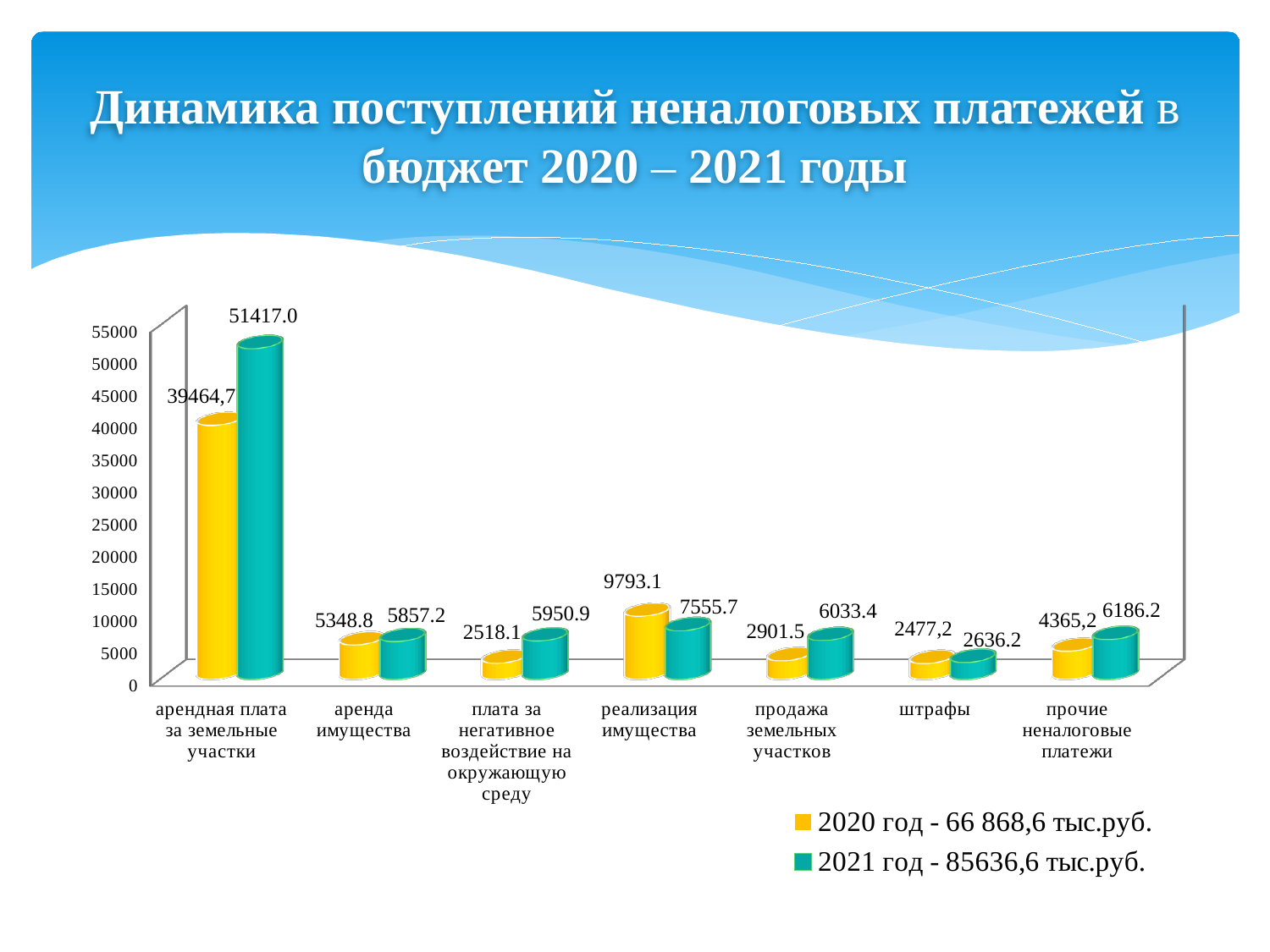
What is the difference between the 2021 and 2020 values for 'продажа земельных участков'? 3131.9 What is the value for 'штрафы' in the 2020 series? 2477,2 How many categories are shown on the x axis? 7 What is the difference between the 2020 and 2021 values for 'реализация имущества'? 2237.4 What is the value for 'плата за негативное воздействие на окружающую среду' in the 2021 series? 5950.9 How many series does the legend list? 2 Which category has the lowest value in the 2020 series? штрафы For 'реализация имущества', which series has the larger value, 2020 or 2021? 2020 What total for 2021 is given in the legend? 85636,6 тыс.руб. What is the value for 'аренда имущества' in the 2020 series? 5348.8 Which category has the highest value in the 2021 series? арендная плата за земельные участки What type of chart is shown on the slide? bar chart